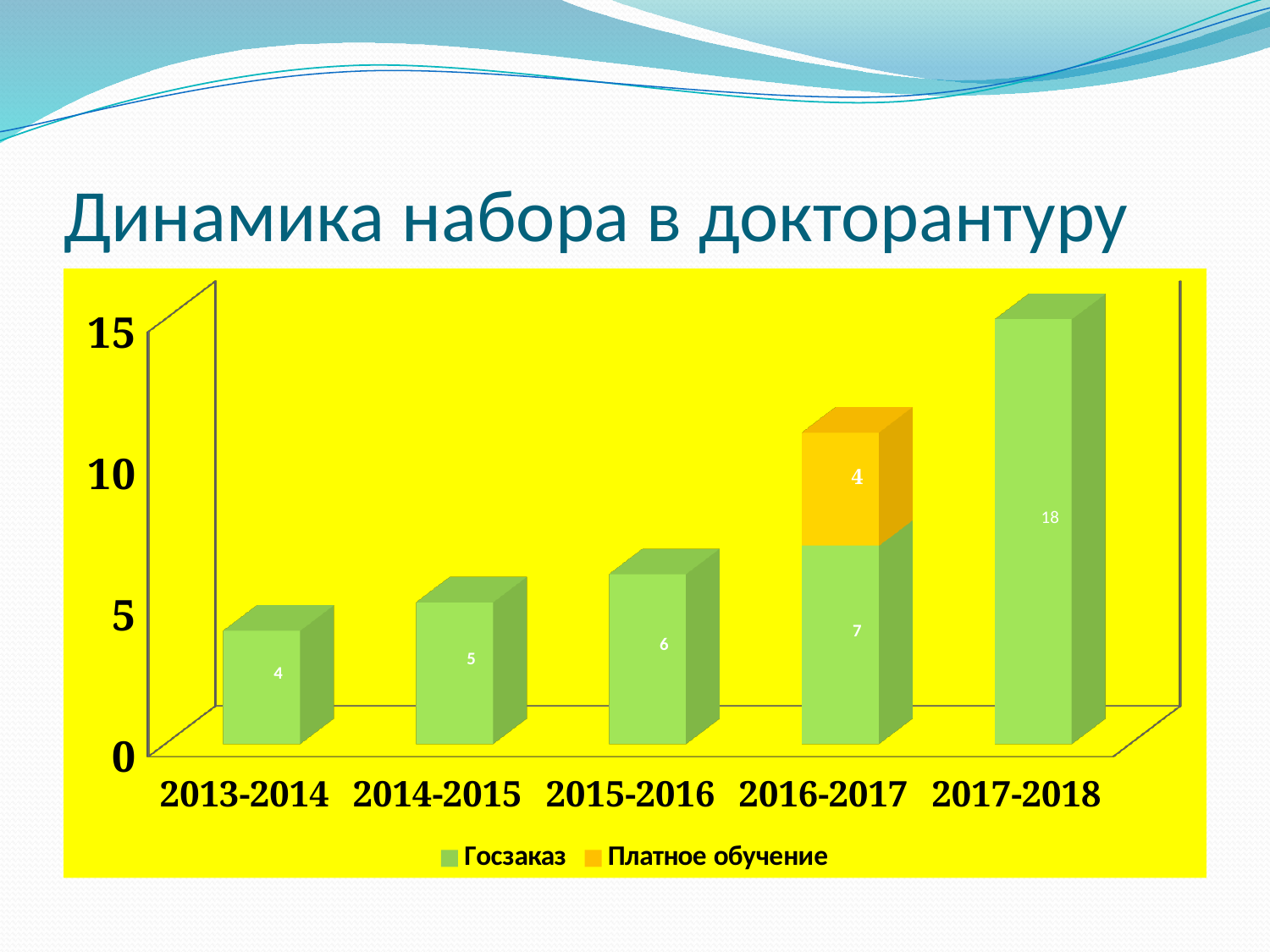
Which year has the lowest Госзаказ value? 2013-2014 What is the total of the stacked bar for 2016-2017? 11 Which is larger, the Госзаказ value for 2014-2015 or for 2015-2016? 2015-2016 What is the value of Госзаказ for 2015-2016? 6 How many year categories are shown on the x axis? 5 Does the Госзаказ value rise or fall from 2013-2014 to 2017-2018? rise What is the value of Платное обучение for 2016-2017? 4 Which year has the highest Госзаказ value? 2017-2018 How many series does the legend list? 2 What is the value of Госзаказ for 2013-2014? 4